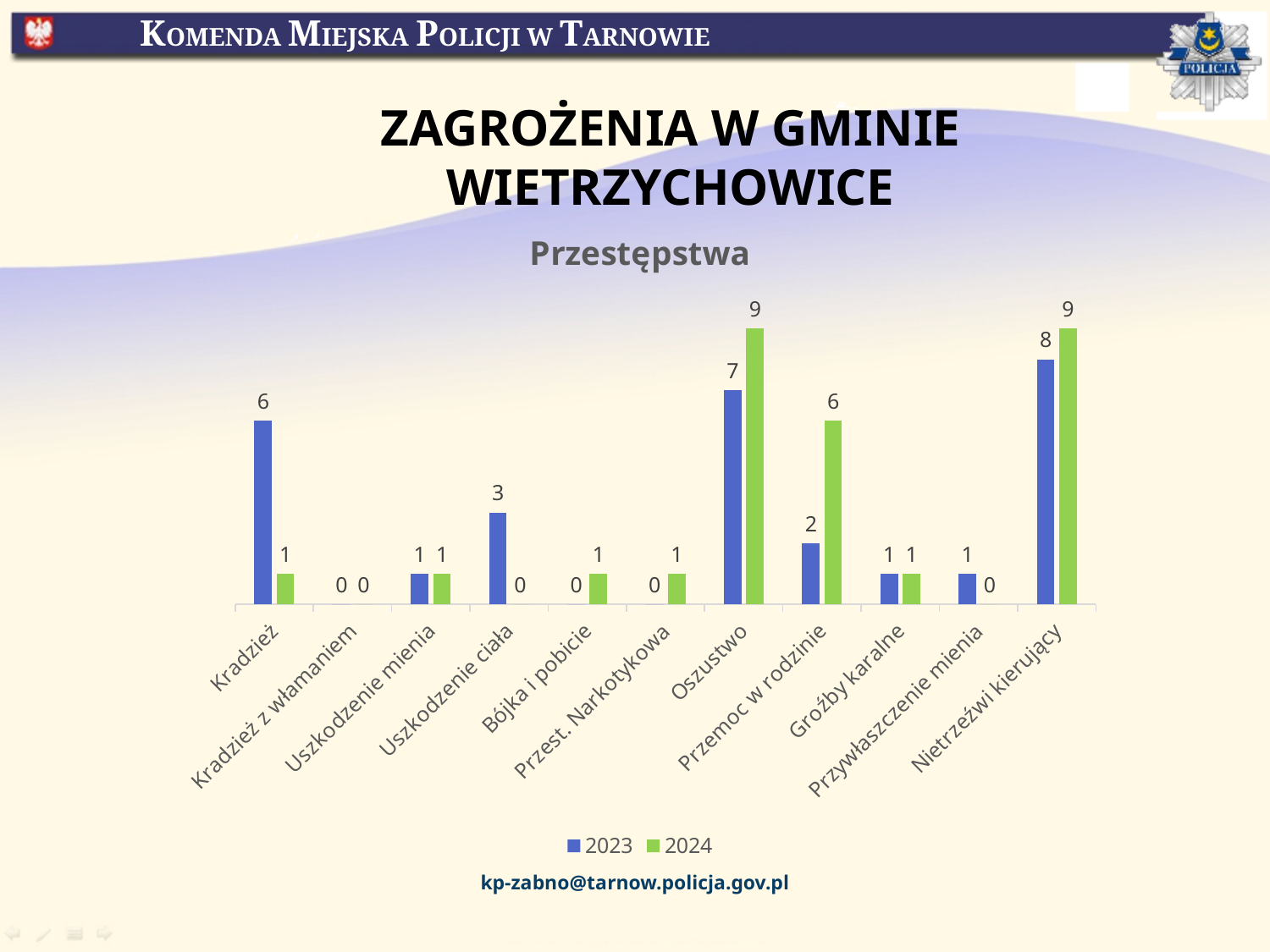
What kind of chart is shown on the slide? Bar chart What is the difference between the 2023 and 2024 values for Kradzież? 5 What is the title of the chart? Przestępstwa What is the value for Uszkodzenie ciała in 2024? 0 What is the value for Przemoc w rodzinie in 2023? 2 Which category has the highest value for 2023? Nietrzeźwi kierujący What is the value for Oszustwo in 2024? 9 How many series does the legend list? 2 What is the value for Kradzież in 2023? 6 How many categories are shown on the x axis? 11 Which is larger for Oszustwo, the 2023 value or the 2024 value? 2024 What is the difference between the 2024 and 2023 values for Przemoc w rodzinie? 4